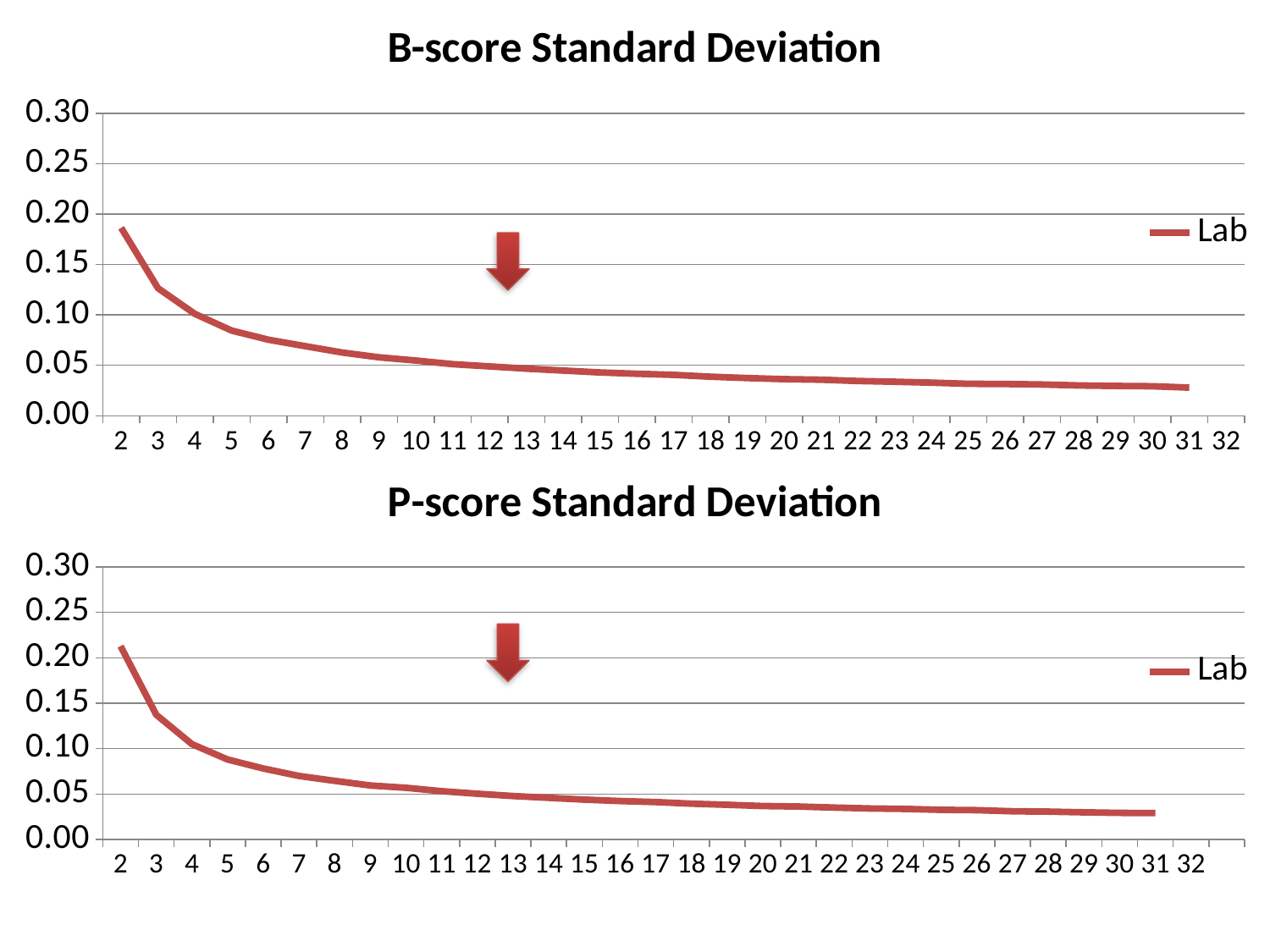
How many series does the legend of the B-score Standard Deviation chart list? 1 In the B-score Standard Deviation chart, at which x value is the line highest? 2 What kind of chart is the B-score Standard Deviation chart? line chart In the B-score Standard Deviation chart, is the value at x = 2 greater or less than 0.15? greater In the B-score Standard Deviation chart, which is larger, the value at x = 3 or the value at x = 10? x = 3 In the P-score Standard Deviation chart, at which x value is the line highest? 2 In the P-score Standard Deviation chart, is the value at x = 2 greater or less than 0.20? greater In the P-score Standard Deviation chart, do the values rise or fall as the x axis increases? fall What series name appears in the legend of the P-score Standard Deviation chart? Lab In the P-score Standard Deviation chart, is the value at x = 20 greater or less than 0.05? less In the B-score Standard Deviation chart, do the values rise or fall as the x axis increases? fall